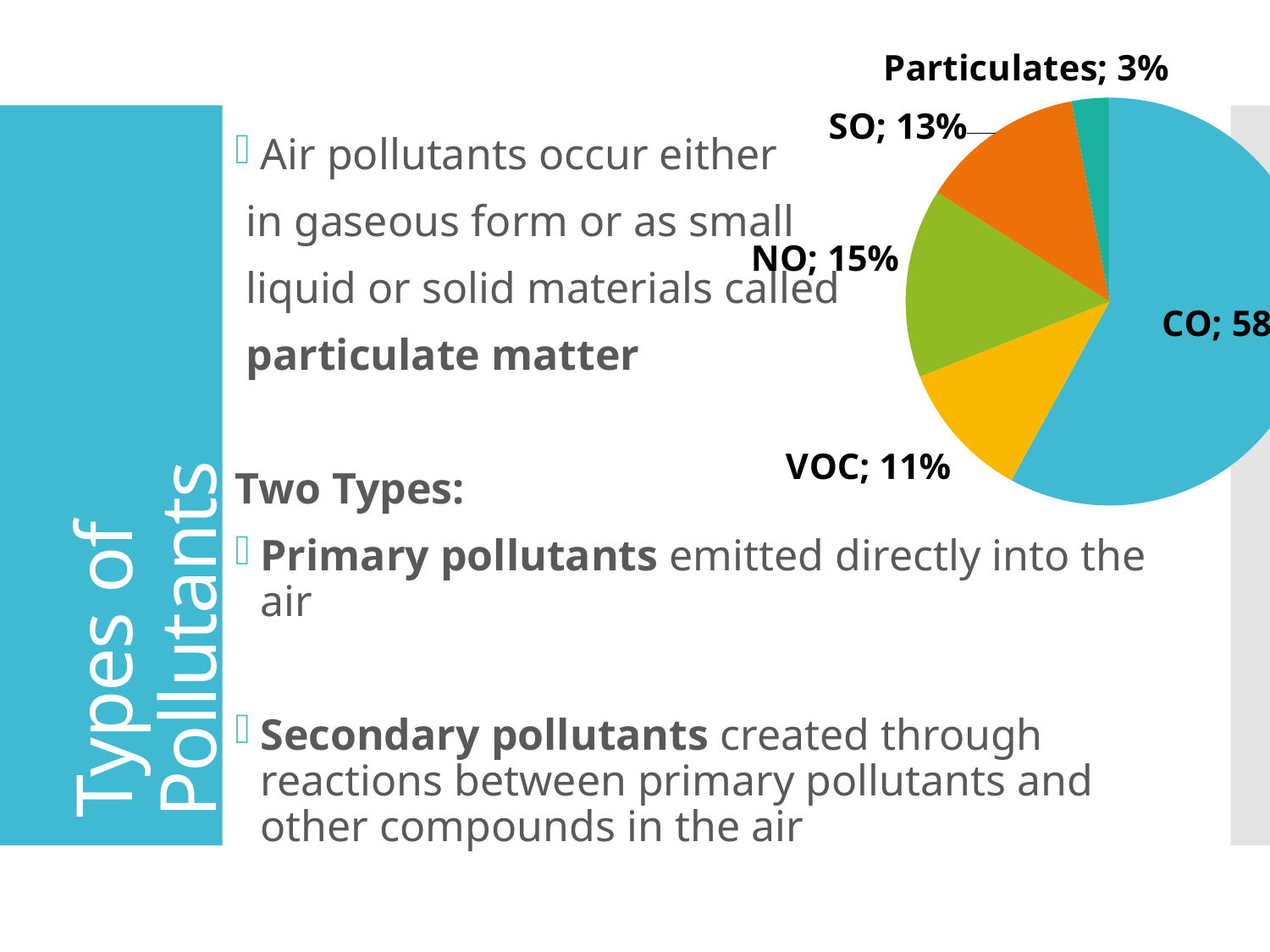
What is the difference between the NO share and the Particulates share? 12% What percentage does the pie chart show for Particulates? 3% How many slices does the pie chart have? 5 Which pollutant has the largest slice in the pie chart? CO What colour is the CO slice in the pie chart? Light blue What percentage does the pie chart show for VOC? 11% How many percentage points larger is the NO share than the SO share? 2% What percentage does the pie chart show for NO? 15% Which pollutant has the smallest slice in the pie chart? Particulates What percentage does the pie chart show for SO? 13% What type of chart is shown on the slide? Pie chart Which has a larger share in the pie chart, NO or VOC? NO